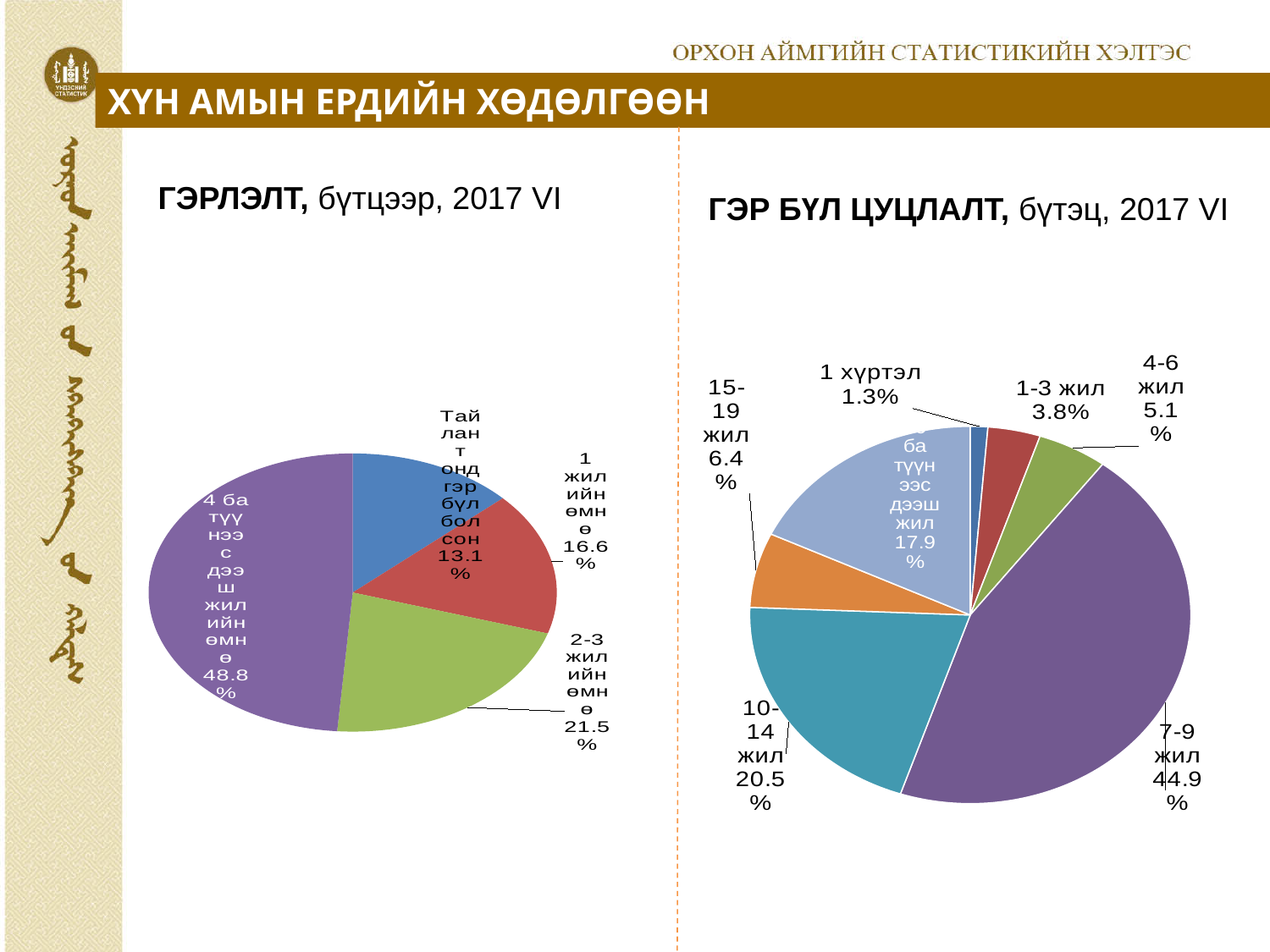
In the ГЭРЛЭЛТ, бүтцээр, 2017 VI chart, which category has the smallest share? Тайлант онд гэр бүл болсон How many slices does the ГЭР БҮЛ ЦУЦЛАЛТ, бүтэц, 2017 VI pie chart have? 7 In the ГЭР БҮЛ ЦУЦЛАЛТ, бүтэц, 2017 VI chart, what is the difference between the shares for '1-3 жил' and '1 хүртэл'? 2.5% In the ГЭР БҮЛ ЦУЦЛАЛТ, бүтэц, 2017 VI chart, which is larger: the share for '15-19 жил' or for '4-6 жил'? 15-19 жил In the ГЭР БҮЛ ЦУЦЛАЛТ, бүтэц, 2017 VI chart, which category has the smallest share? 1 хүртэл In the ГЭРЛЭЛТ, бүтцээр, 2017 VI chart, what share is shown for '4 ба түүнээс дээш жилийн өмнө'? 48.8% What type of chart is used on the left side of the slide (ГЭРЛЭЛТ, бүтцээр, 2017 VI)? Pie chart How many slices does the ГЭРЛЭЛТ, бүтцээр, 2017 VI pie chart have? 4 In the ГЭРЛЭЛТ, бүтцээр, 2017 VI chart, what share is shown for 'Тайлант онд гэр бүл болсон'? 13.1% In the ГЭР БҮЛ ЦУЦЛАЛТ, бүтэц, 2017 VI chart, what share is shown for '7-9 жил'? 44.9% In the ГЭРЛЭЛТ, бүтцээр, 2017 VI chart, what is the difference between the shares for '2-3 жилийн өмнө' and '1 жилийн өмнө'? 4.9% In the ГЭР БҮЛ ЦУЦЛАЛТ, бүтэц, 2017 VI chart, what share is shown for '10-14 жил'? 20.5%